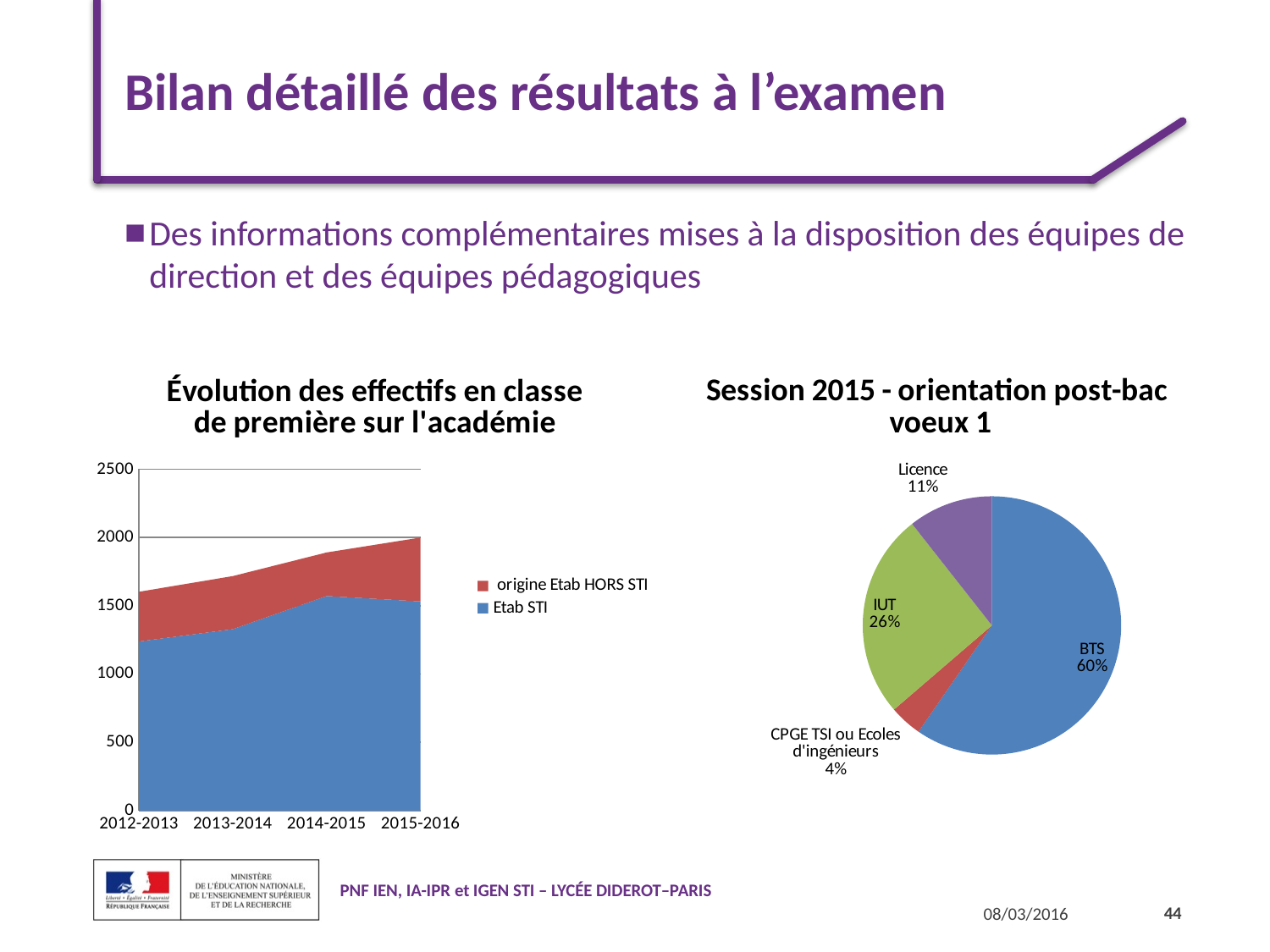
How many school years are shown on the x axis of the chart 'Évolution des effectifs en classe de première sur l'académie'? 4 In the chart 'Évolution des effectifs en classe de première sur l'académie', is the value for Etab STI in 2012-2013 greater or less than 1500? less How many slices does the pie chart 'Session 2015 - orientation post-bac voeux 1' have? 4 In the pie chart 'Session 2015 - orientation post-bac voeux 1', which is larger, the Licence share or the IUT share? IUT How many series does the legend of the chart 'Évolution des effectifs en classe de première sur l'académie' list? 2 What kind of chart is 'Session 2015 - orientation post-bac voeux 1'? Pie chart In the pie chart 'Session 2015 - orientation post-bac voeux 1', which category has the largest slice? BTS What kind of chart is 'Évolution des effectifs en classe de première sur l'académie'? Stacked area chart In the pie chart 'Session 2015 - orientation post-bac voeux 1', what share does IUT have? 26% In the pie chart 'Session 2015 - orientation post-bac voeux 1', which category has the smallest slice? CPGE TSI ou Ecoles d'ingénieurs In the pie chart 'Session 2015 - orientation post-bac voeux 1', how many percentage points larger is the BTS share than the IUT share? 34 percentage points In the pie chart 'Session 2015 - orientation post-bac voeux 1', what share does BTS have? 60%